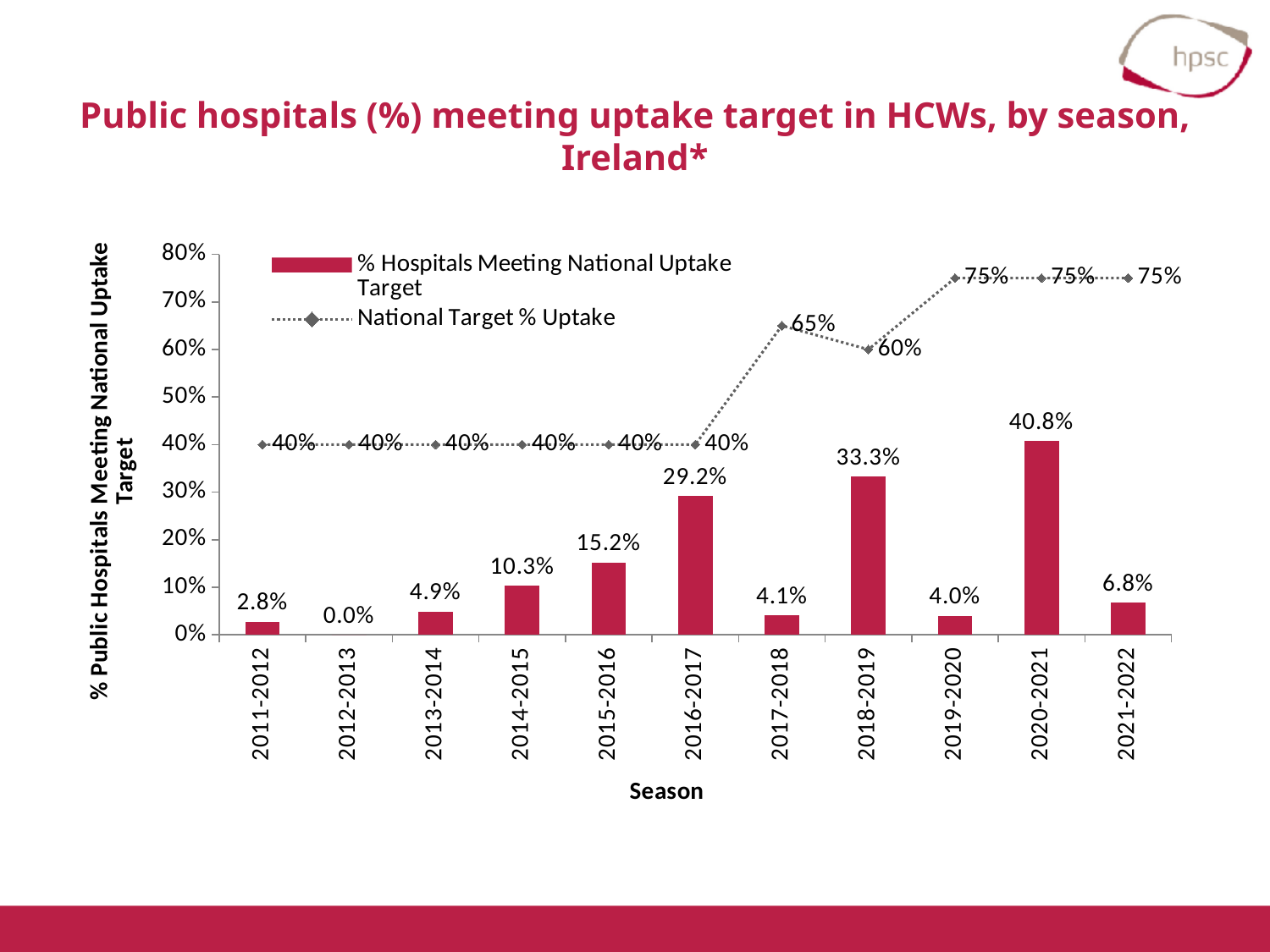
What is the label of the x axis? Season What is the difference between the percentage of hospitals meeting the target in 2020-2021 and in 2021-2022? 34.0% What was the National Target % Uptake for the 2017-2018 season? 65% What percentage of public hospitals met the national uptake target in the 2020-2021 season? 40.8% How many seasons are shown on the x axis? 11 What is the difference between the National Target % Uptake and the percentage of hospitals meeting it in the 2019-2020 season? 71.0% Which season had a higher percentage of hospitals meeting the target, 2016-2017 or 2018-2019? 2018-2019 Which season had the highest percentage of public hospitals meeting the national uptake target? 2020-2021 Which season had the lowest percentage of public hospitals meeting the national uptake target? 2012-2013 Did the National Target % Uptake rise or fall between the 2018-2019 and 2019-2020 seasons? Rise How many series does the legend list? 2 What kind of chart is used to show the % Hospitals Meeting National Uptake Target series? Bar chart